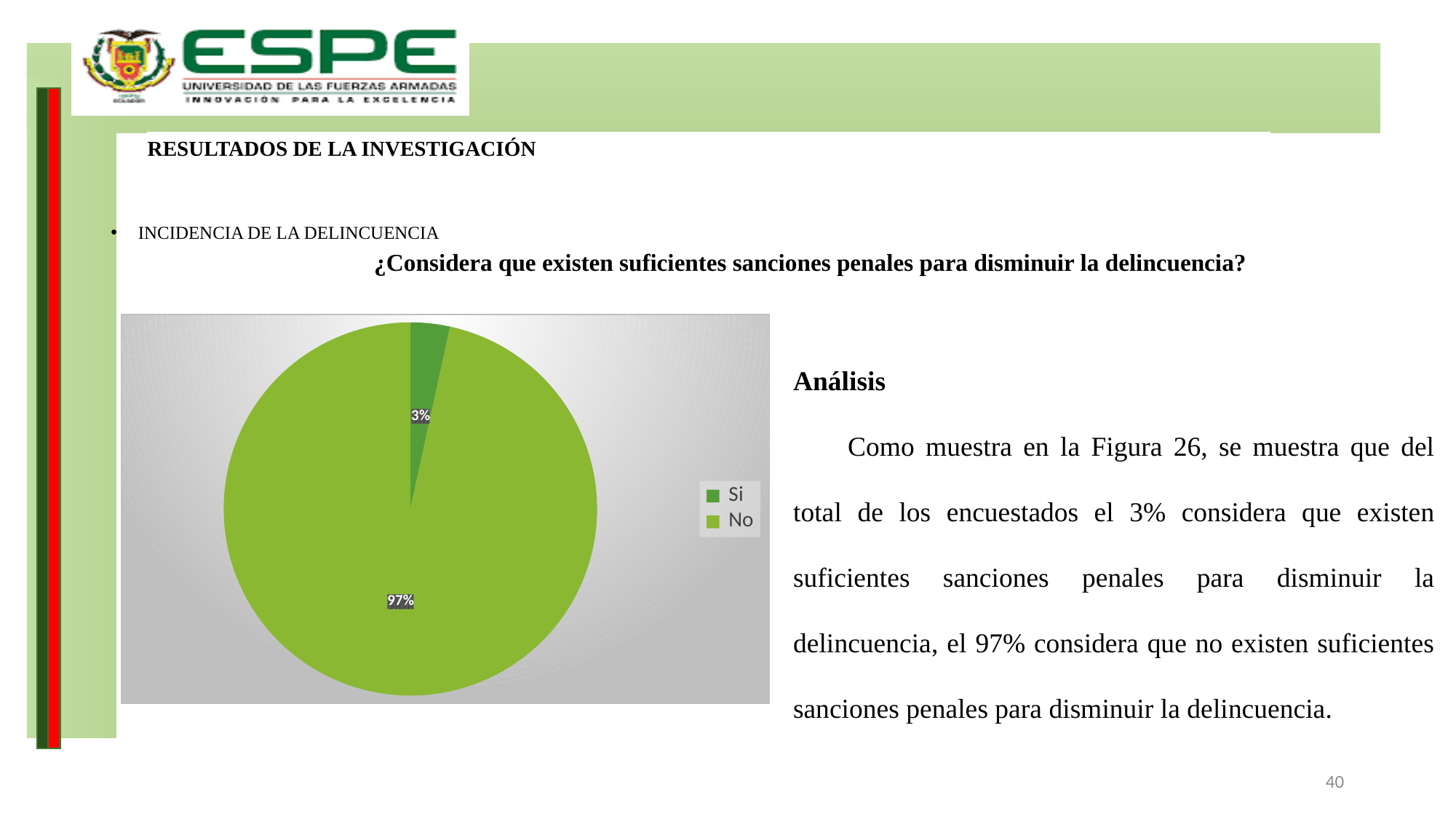
Which legend entry is shown in the darker green colour? Si Which is larger, the "Si" slice or the "No" slice? No What question does the pie chart answer, according to the title above it? ¿Considera que existen suficientes sanciones penales para disminuir la delincuencia? Which category has the largest share of the pie? No What kind of chart is shown on the slide? Pie chart What share of the pie does the "No" slice represent? 97% What percentage of respondents answered "No"? 97% What is the difference in percentage points between the "No" and "Si" slices? 94 How many categories does the pie chart show? 2 How many entries does the legend list? 2 What percentage of respondents answered "Si"? 3% Which category has the smallest share of the pie? Si